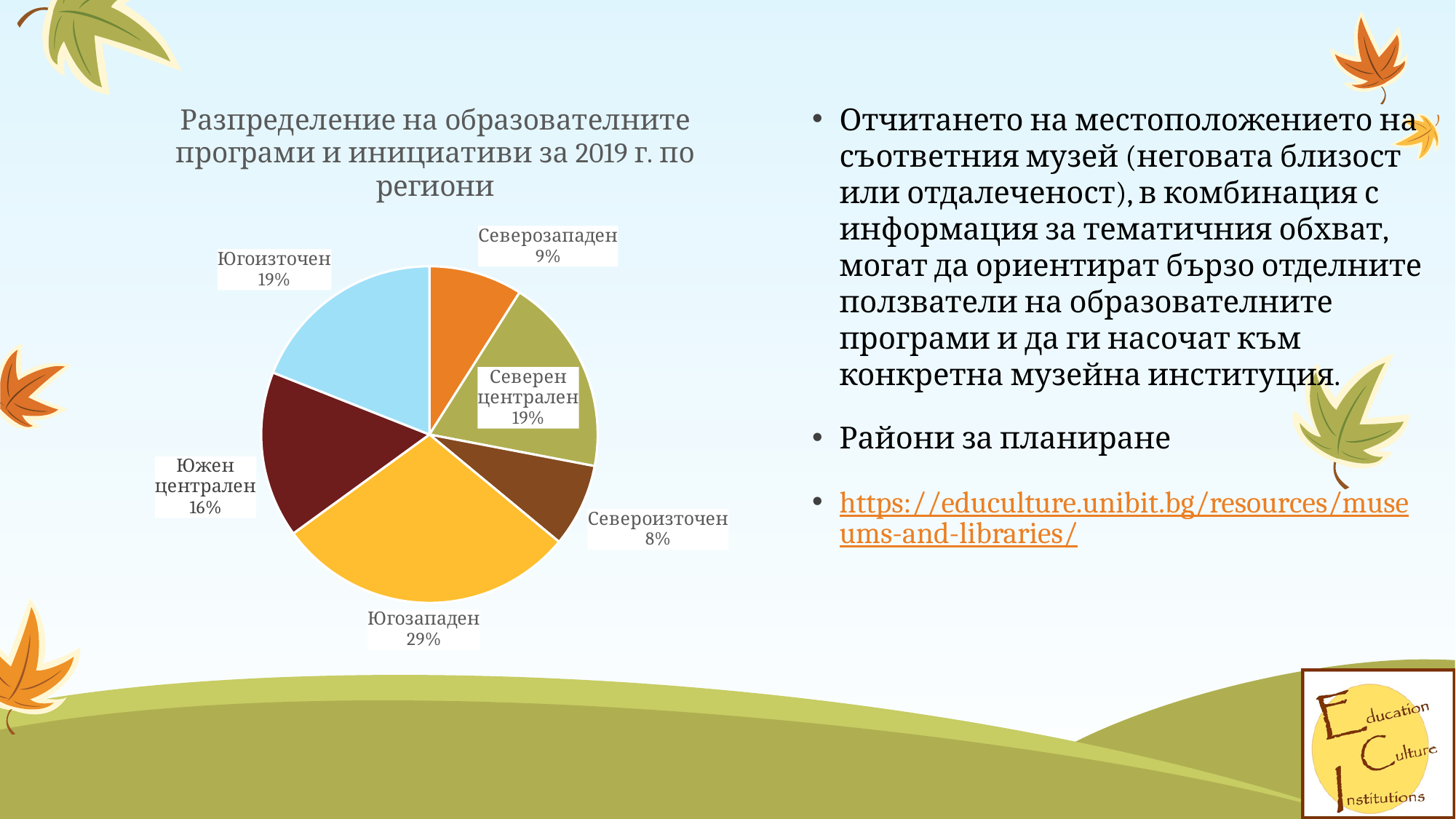
What is the value for Южен централен? 16% What kind of chart is shown on the slide? Pie chart What is the title of the chart? Разпределение на образователните програми и инициативи за 2019 г. по региони What percentage is shown for Североизточен? 8% How many regions are shown in the pie chart? 6 What is the combined share of Югоизточен and Северен централен? 38% Which is larger, the share for Югоизточен or the share for Южен централен? Югоизточен Which region has the smallest slice of the pie? Североизточен What percentage is shown for Северозападен? 9% What share of the pie does Югозападен have? 29% What is the difference in percentage points between Югозападен and Североизточен? 21 Which region has the largest slice of the pie? Югозападен